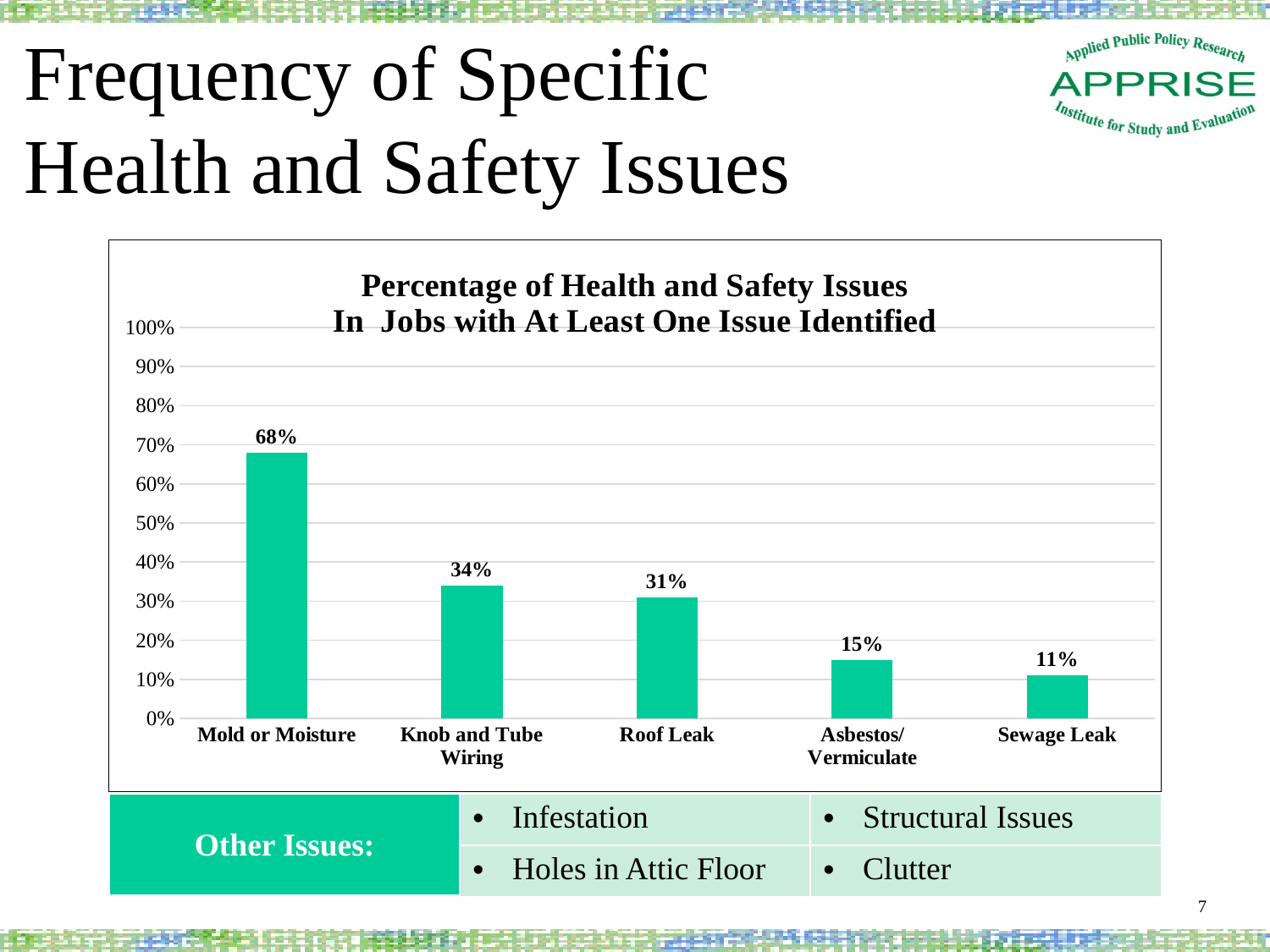
Which health and safety issue has the lowest percentage? Sewage Leak Is the value for Sewage Leak greater or less than 20%? less How many categories are shown on the chart? 5 What percentage of jobs with at least one issue identified had Mold or Moisture? 68% Which is larger, the value for Roof Leak or the value for Asbestos/Vermiculate? Roof Leak What is the value shown for Roof Leak? 31% What is the value shown for Knob and Tube Wiring? 34% Which health and safety issue has the highest percentage? Mold or Moisture What is the title of the chart? Percentage of Health and Safety Issues In Jobs with At Least One Issue Identified What is the difference between the percentages for Mold or Moisture and Knob and Tube Wiring? 34% What is the value shown for Asbestos/Vermiculate? 15% What kind of chart is shown on the slide? Bar chart